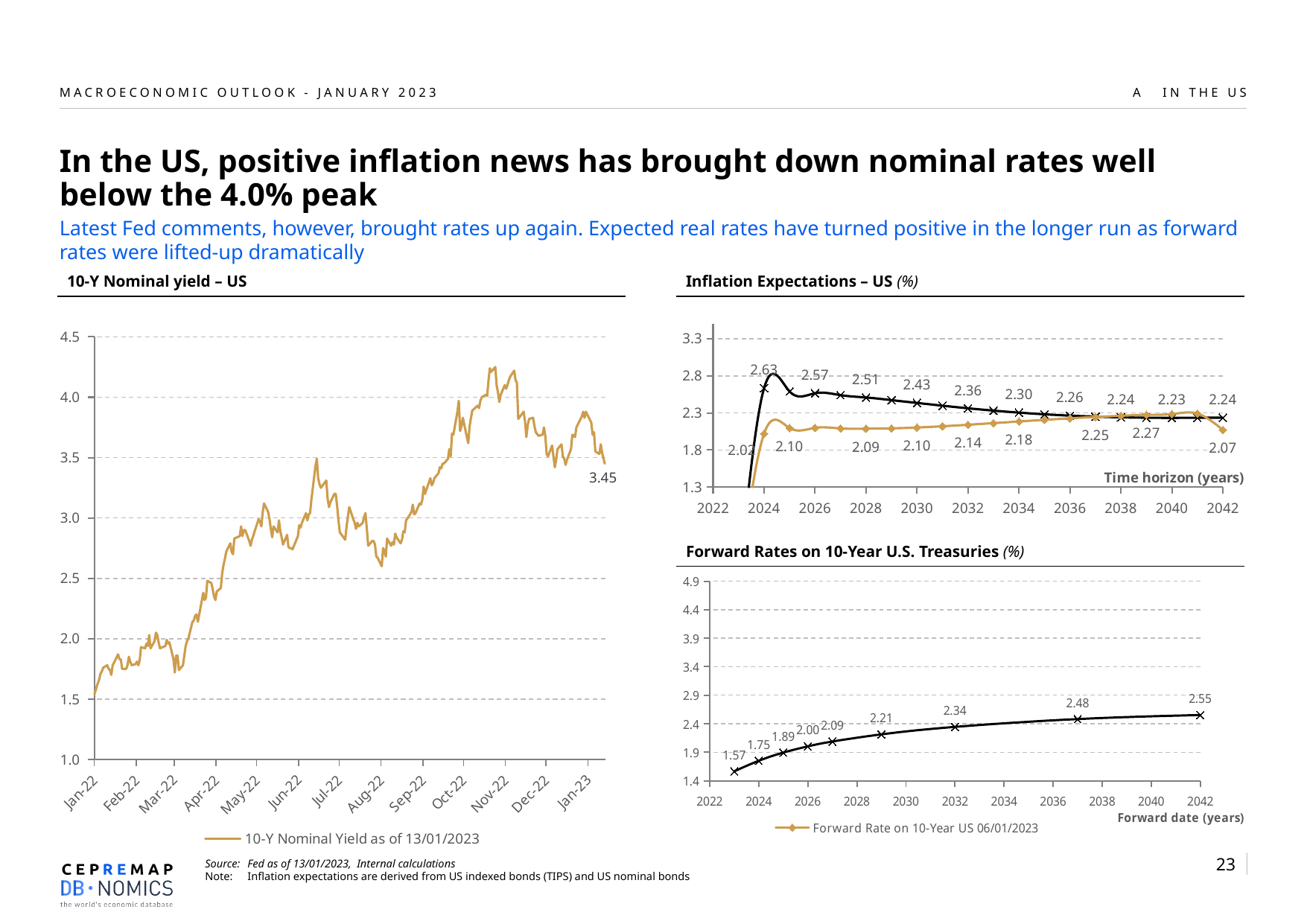
On the 'Inflation Expectations – US' chart, what is the value labeled on the black line at 2042? 2.24 On the 'Forward Rates on 10-Year U.S. Treasuries' chart, do the values rise or fall as the forward date increases? rise On the '10-Y Nominal yield – US' chart, is the yield at the start of Jan-22 greater or less than 2.0? less What is the legend entry shown below the 'Forward Rates on 10-Year U.S. Treasuries' chart? Forward Rate on 10-Year US 06/01/2023 On the 'Inflation Expectations – US' chart, what is the highest labeled value? 2.63 On the 'Forward Rates on 10-Year U.S. Treasuries' chart, what is the value labeled at 2042? 2.55 On the 'Forward Rates on 10-Year U.S. Treasuries' chart, what is the lowest labeled value? 1.57 On the 'Forward Rates on 10-Year U.S. Treasuries' chart, what is the difference between the highest labeled value (2.55) and the lowest labeled value (1.57)? 0.98 On the '10-Y Nominal yield – US' chart, is the peak of the line in Nov-22 greater or less than 4.0? greater On the '10-Y Nominal yield – US' chart, what is the value printed at the end of the line in Jan-23? 3.45 What kind of chart is the '10-Y Nominal yield – US' chart? line chart How many labeled data points are on the 'Forward Rates on 10-Year U.S. Treasuries' chart? 9